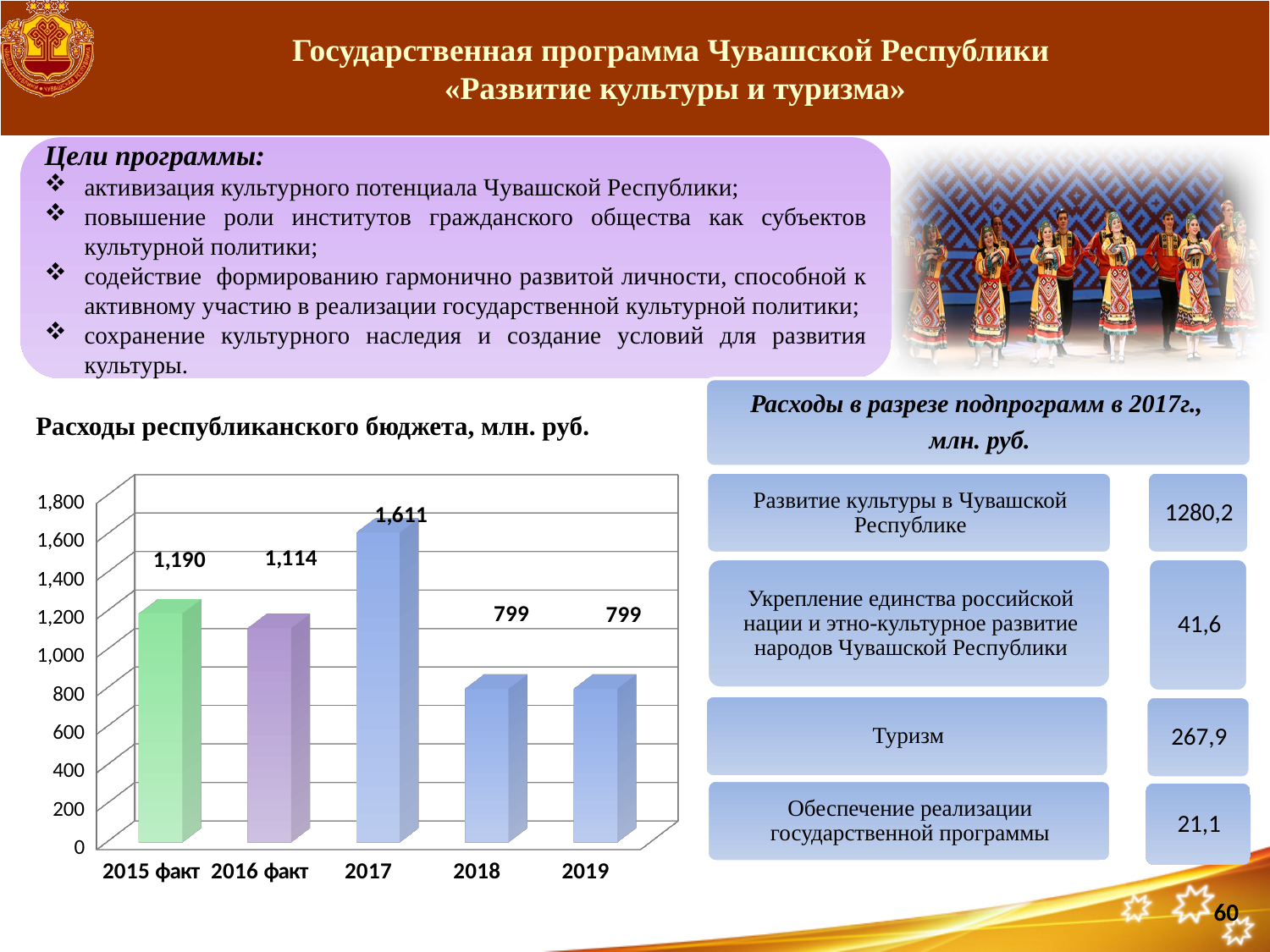
What is the value for 2019 in the chart? 799 Which is larger, the value for 2015 факт or the value for 2016 факт? 2015 факт What is the value for 2016 факт in the chart? 1,114 Which category has the highest value in the chart? 2017 What is the difference between the values for 2015 факт and 2016 факт? 76 How many categories are shown on the x axis of the chart? 5 What is the title of the chart on the slide? Расходы республиканского бюджета, млн. руб. What kind of chart is shown on the slide? bar chart What is the value for 2015 факт in the chart? 1,190 What is the difference between the values for 2017 and 2018? 812 Is the value for 2018 greater or less than 1,000? less What is the value for 2017 in the chart "Расходы республиканского бюджета, млн. руб."? 1,611